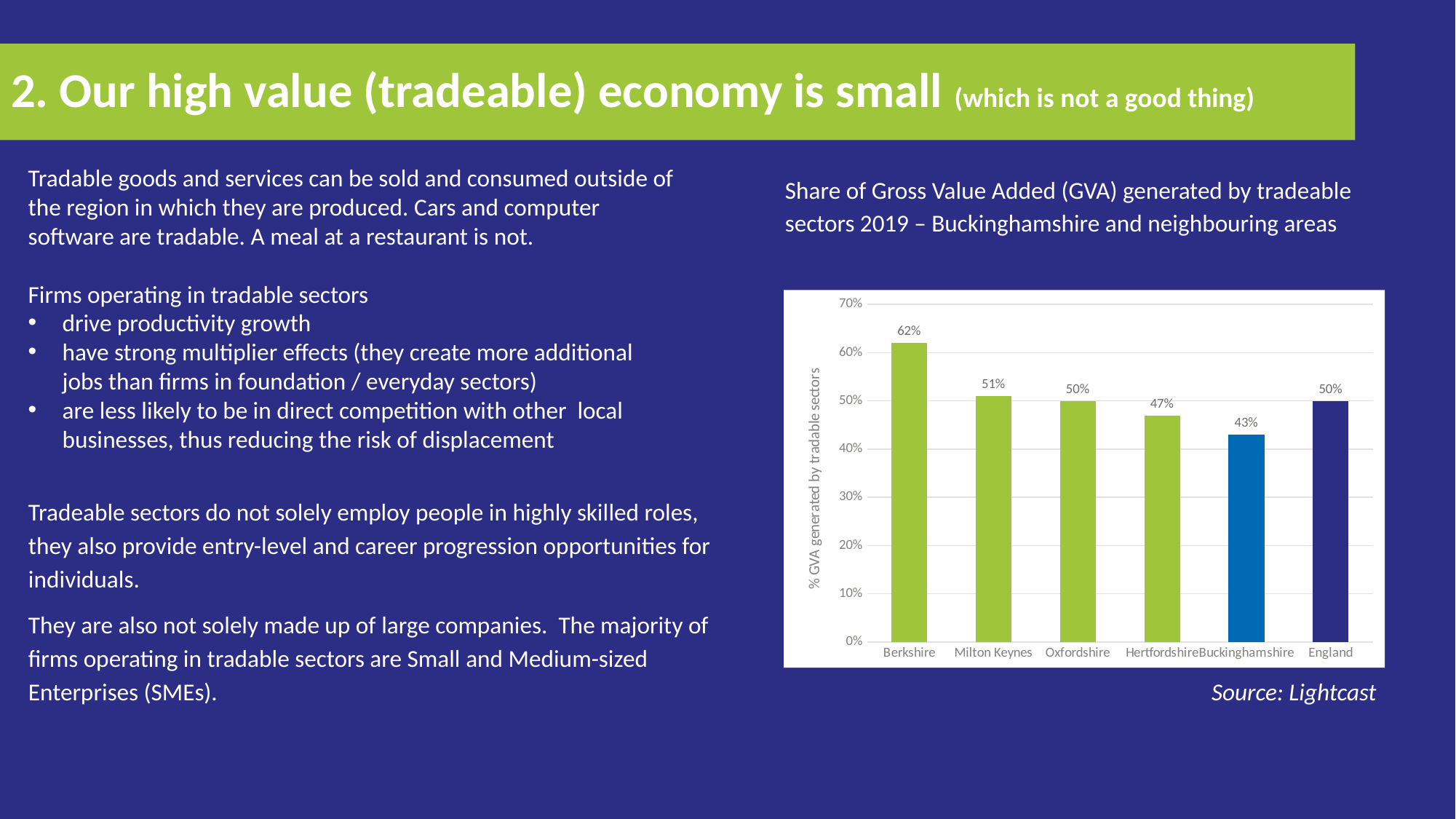
Which area has the highest share of GVA generated by tradable sectors? Berkshire What is the difference between Berkshire's and Buckinghamshire's share of GVA generated by tradable sectors? 19% What is the label on the vertical axis of the chart? % GVA generated by tradable sectors Which has a larger share of GVA generated by tradable sectors, Milton Keynes or Hertfordshire? Milton Keynes What is the share of GVA generated by tradable sectors for Buckinghamshire? 43% What is the share of GVA generated by tradable sectors for Hertfordshire? 47% Which area has the lowest share of GVA generated by tradable sectors? Buckinghamshire What is the share of GVA generated by tradable sectors for Berkshire? 62% Is the value for Buckinghamshire greater or less than 50%? less How many areas are shown on the chart? 6 What is the share of GVA generated by tradable sectors for England? 50% What kind of chart is shown on the slide? Bar chart